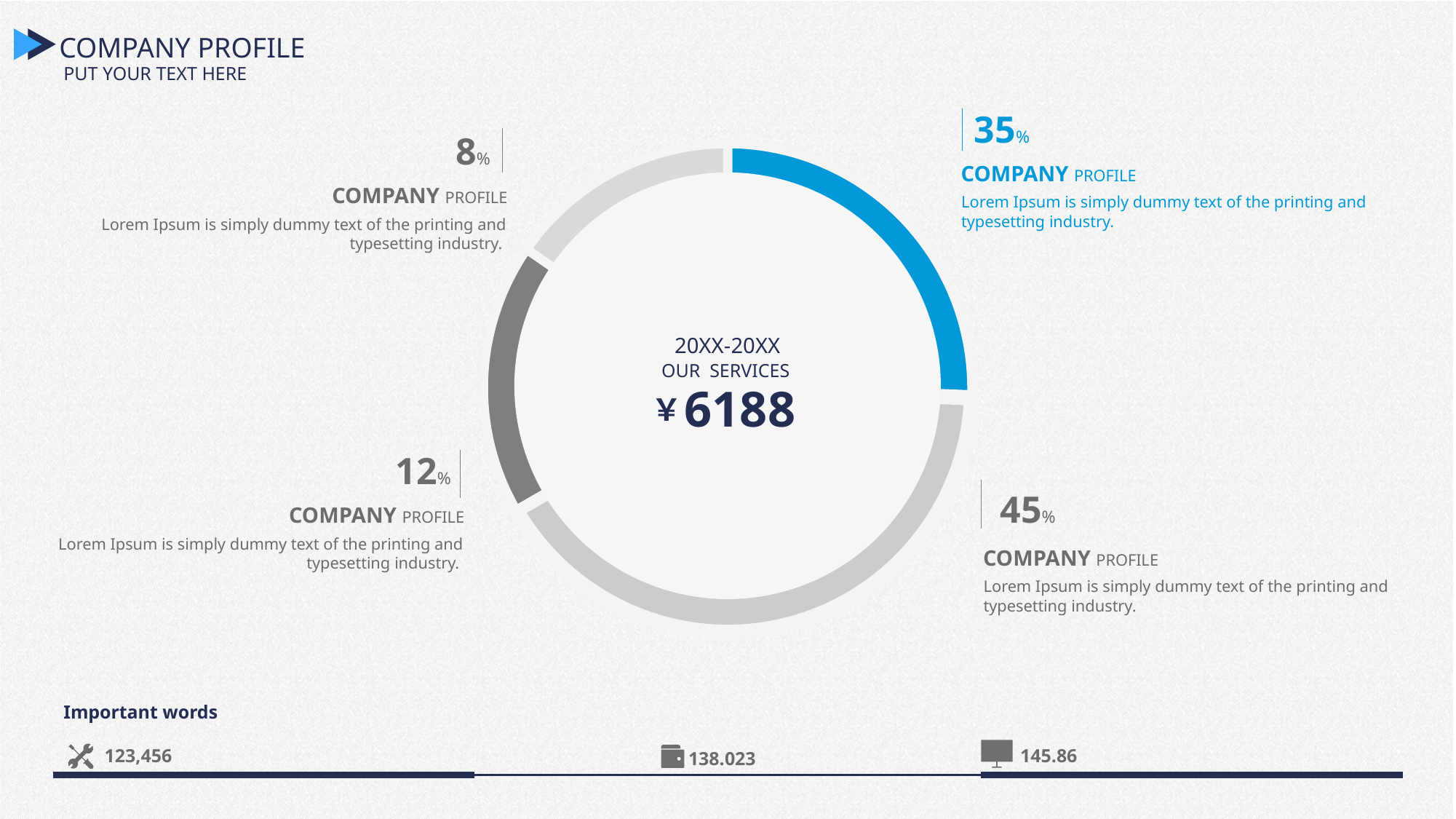
What is the largest percentage shown on the donut chart? 45% How many segments does the donut chart have? 4 What is the smallest percentage shown on the donut chart? 8% What value is printed in the centre of the donut chart? ¥6188 What kind of chart is shown on the slide? Donut (pie) chart Which is larger, the blue segment or the dark gray segment? The blue segment What period is shown in the centre of the donut chart? 20XX-20XX What is the difference between the largest segment (45%) and the blue segment (35%)? 10 percentage points What is the sum of the four percentages shown around the donut chart? 100%